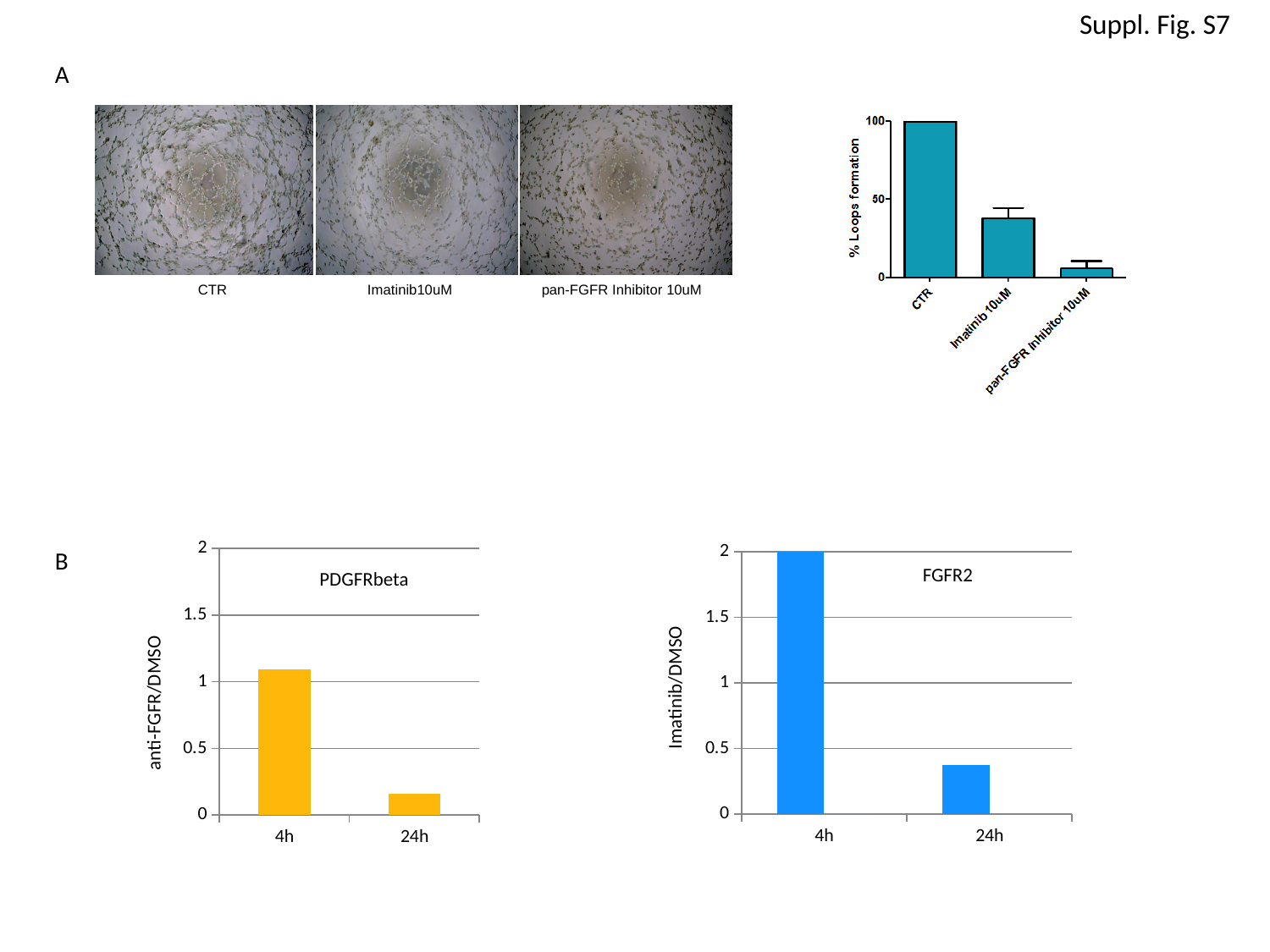
In the % Loops formation chart, which category has the highest value? CTR In the FGFR2 chart, is the value for 24h greater or less than 0.5? less What kind of chart is the FGFR2 chart? bar chart In the % Loops formation chart, how many categories are shown on the x axis? 3 In the % Loops formation chart, what is the value for CTR? 100 In the % Loops formation chart, what is the y-axis label? % Loops formation In the PDGFRbeta chart, which time point has the higher value, 4h or 24h? 4h In the PDGFRbeta chart, is the value for 4h greater or less than 1? greater In the PDGFRbeta chart, is the value for 24h greater or less than 0.5? less In the % Loops formation chart, which category has the lowest value? pan-FGFR Inhibitor 10uM